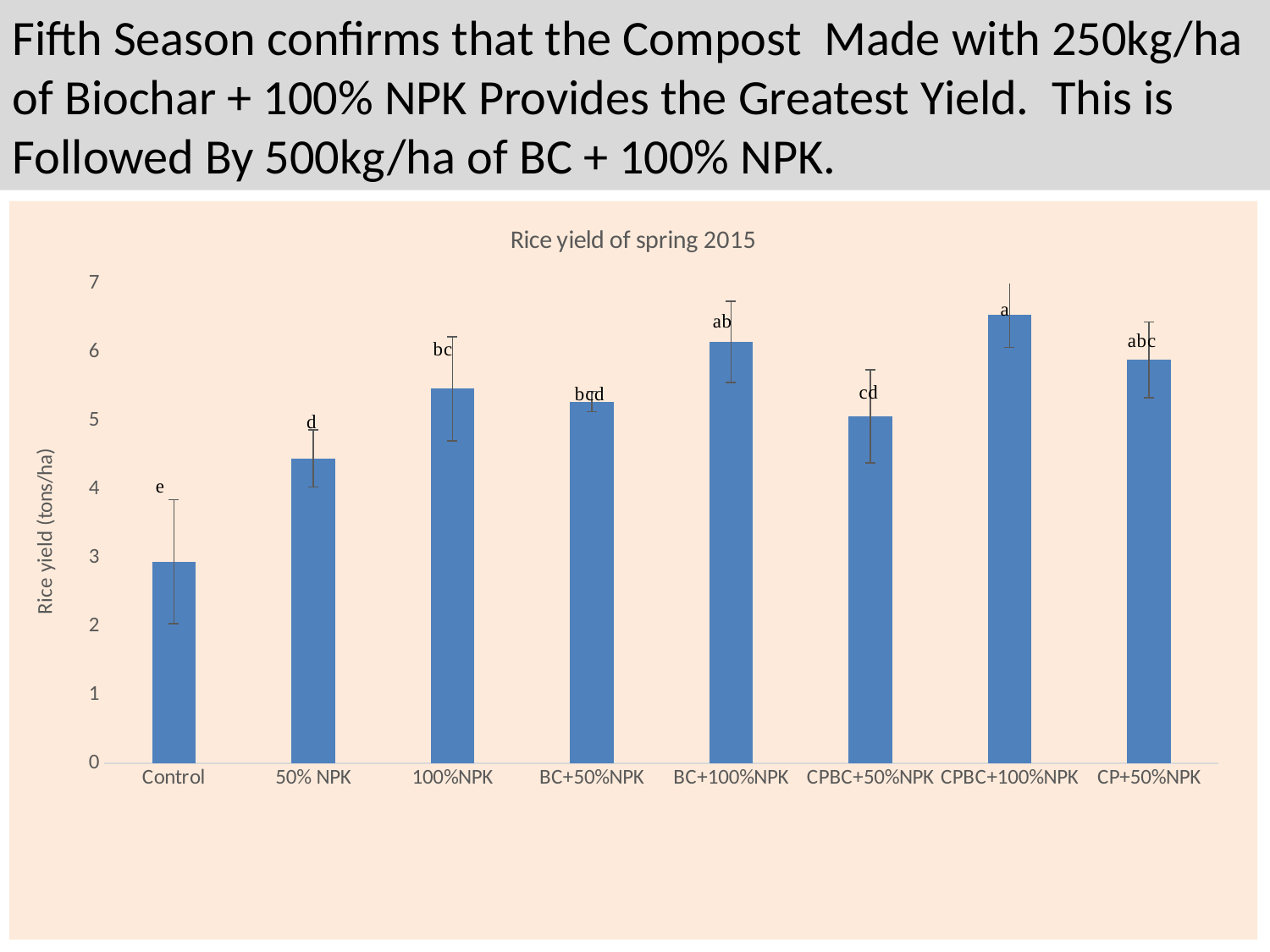
What kind of chart is shown on the slide? bar chart Which has the larger rice yield, BC+100%NPK or CPBC+50%NPK? BC+100%NPK Is the rice yield for 50% NPK greater or less than 5 tons/ha? less How many treatment categories are plotted on the x axis? 8 Is the rice yield for BC+100%NPK greater or less than 6 tons/ha? greater Which treatment has the highest rice yield? CPBC+100%NPK Is the rice yield for CPBC+100%NPK greater or less than 6 tons/ha? greater Which has the larger rice yield, 50% NPK or CP+50%NPK? CP+50%NPK What is the title of the chart? Rice yield of spring 2015 What is the label on the y axis of the chart? Rice yield (tons/ha) Which treatment has the lowest rice yield? Control